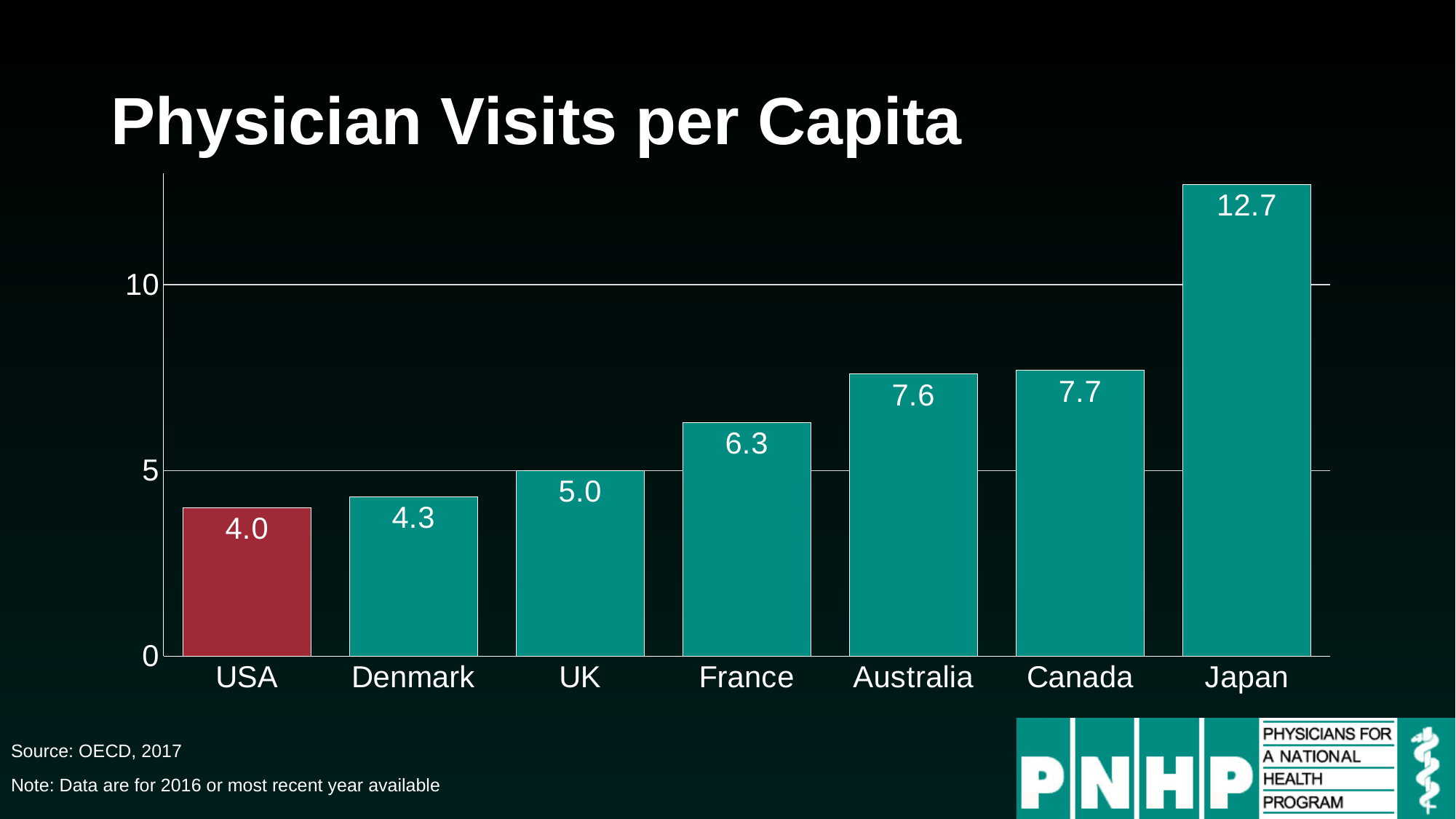
Which country has the lowest number of physician visits per capita? USA Is the value for Canada greater or less than 5? greater Which country has the highest number of physician visits per capita? Japan What is the value for Japan? 12.7 What is the difference between the values for Japan and the USA? 8.7 What is the value for France? 6.3 Which is larger, the value for France or the value for the UK? France What is the value for the USA? 4.0 What is the difference between the values for Australia and Denmark? 3.3 Which bar is shown in a different colour from the others? USA How many countries are shown in the chart? 7 What kind of chart is shown on the slide? Bar chart